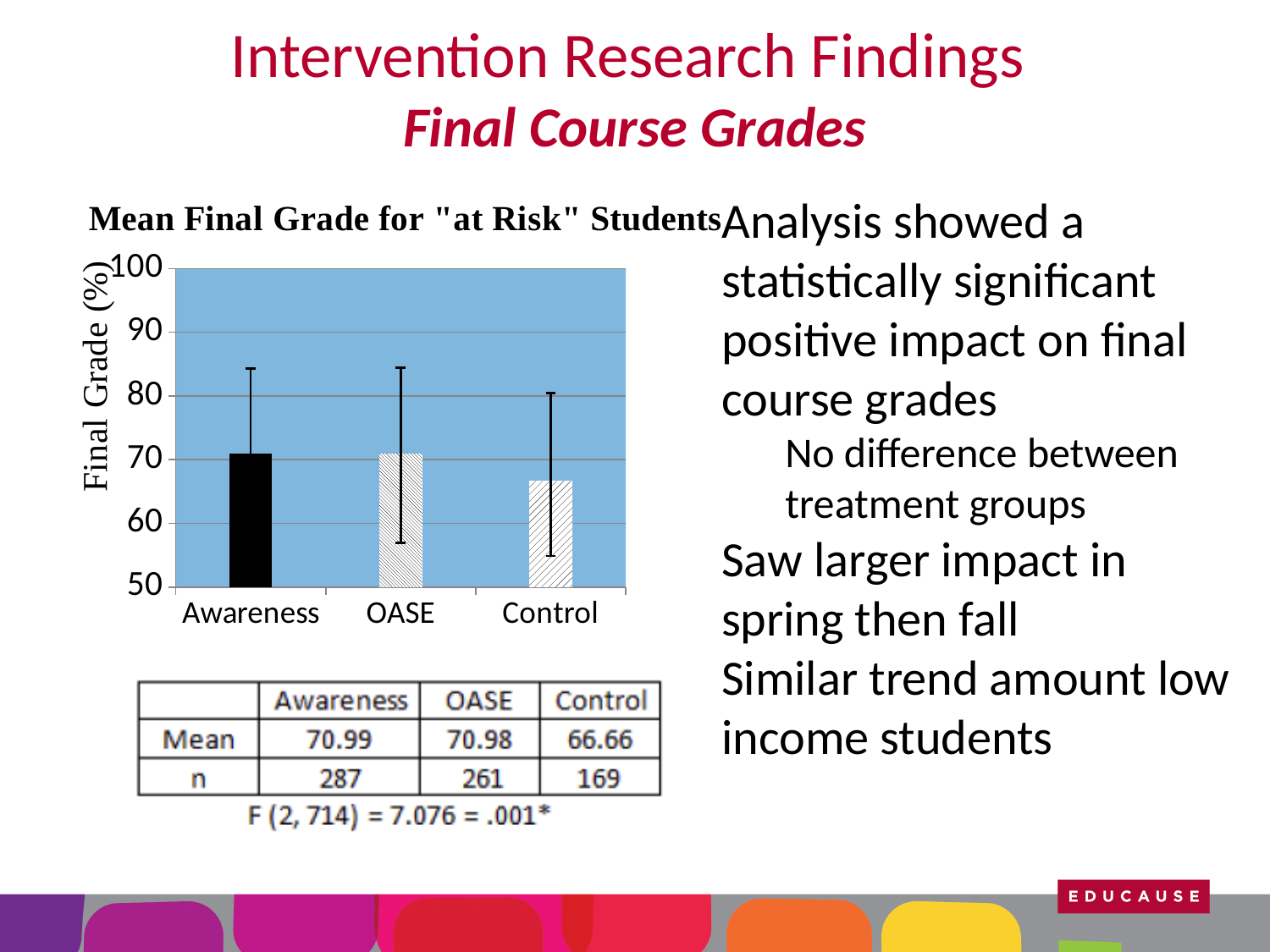
What is the title of the chart? Mean Final Grade for "at Risk" Students Using the means in the table, what is the difference between the Awareness mean and the Control mean? 4.33 Is the mean final grade for OASE greater or less than 80? less How many categories are plotted in the chart? 3 What type of chart is shown on the slide? bar chart Is the mean final grade for Control greater or less than 60? greater According to the table below the chart, what is the mean final grade for Control? 66.66 Which category has the lowest mean final grade? Control Which is larger, the mean final grade for Awareness or for Control? Awareness Is the mean final grade for Control greater or less than 70? less According to the table below the chart, what is the mean final grade for Awareness? 70.99 What is the label of the vertical axis of the chart? Final Grade (%)